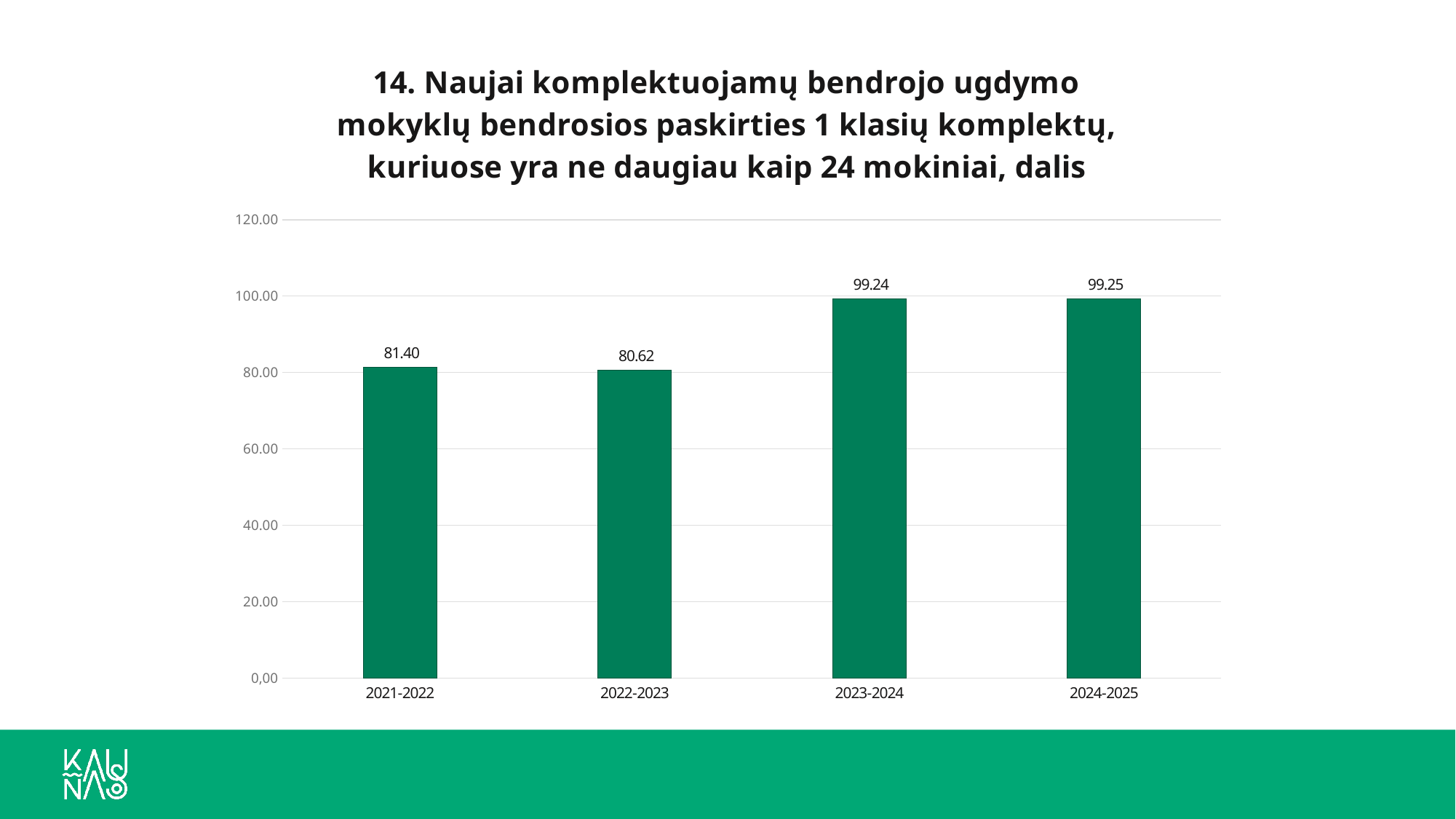
Is the value for 2024-2025 greater or less than 80.00? greater What is the difference between the values for 2021-2022 and 2022-2023? 0.78 What is the highest tick value shown on the vertical axis? 120.00 What is the value for 2024-2025? 99.25 What is the difference between the values for 2023-2024 and 2022-2023? 18.62 Is the value for 2022-2023 greater or less than 100.00? less What is the value for 2023-2024? 99.24 Which is larger, the value for 2021-2022 or the value for 2023-2024? 2023-2024 How many categories (school years) are shown on the x axis? 4 What is the value for 2022-2023? 80.62 What type of chart is shown on the slide? bar chart What is the value for 2021-2022? 81.40